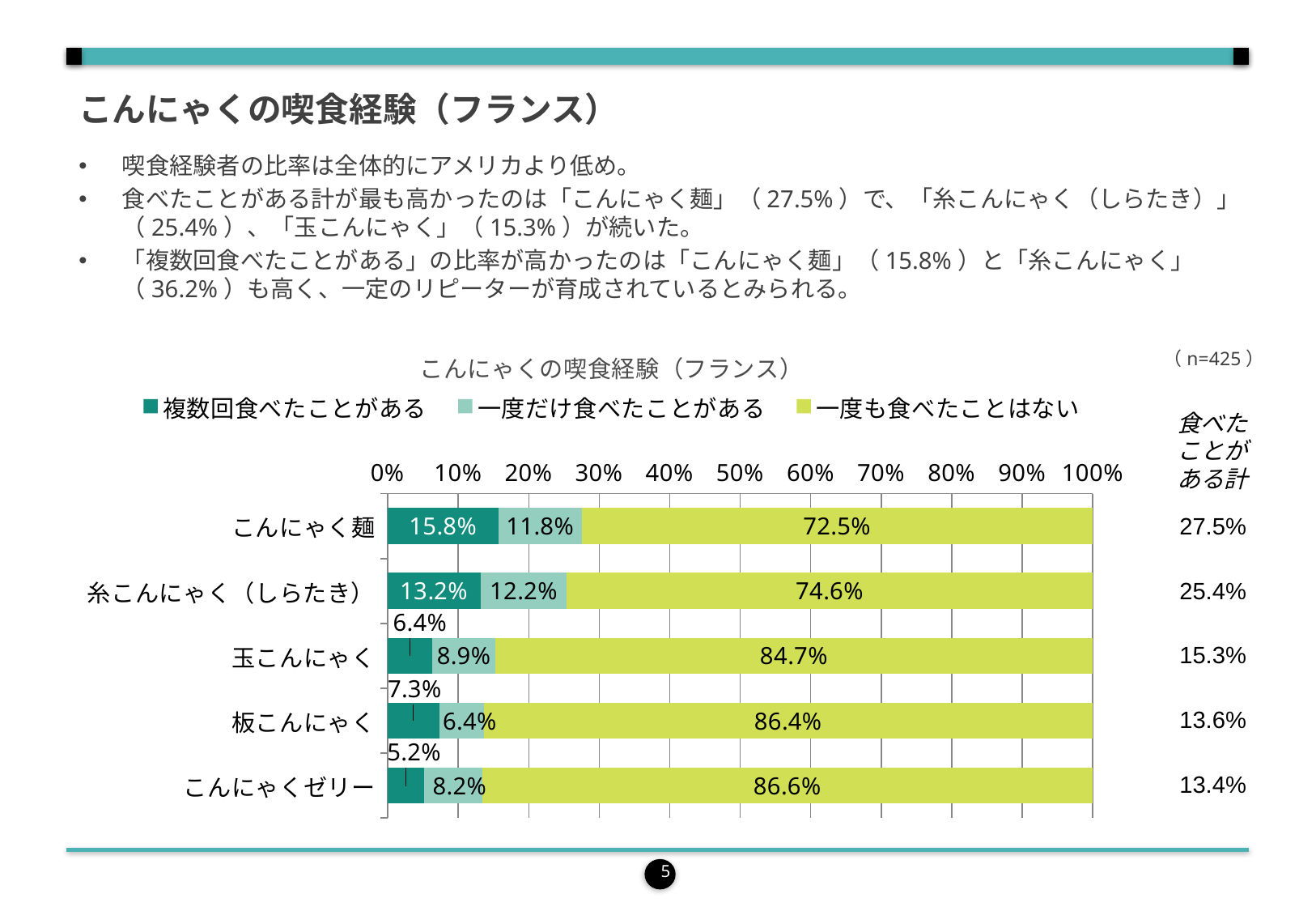
Is the 一度も食べたことはない value for こんにゃく麺 greater or less than 70%? greater What is the value of 一度も食べたことはない for 糸こんにゃく（しらたき）? 74.6% What is the combined total of 複数回食べたことがある and 一度だけ食べたことがある for 玉こんにゃく? 15.3% What is the difference between the 一度も食べたことはない values for 板こんにゃく and こんにゃく麺? 13.9% Which category has the highest value for 一度も食べたことはない? こんにゃくゼリー How many categories are shown on the chart? 5 Which category has the lowest value for 複数回食べたことがある? こんにゃくゼリー What is the value of 複数回食べたことがある for こんにゃく麺? 15.8% What is the value of 一度だけ食べたことがある for 玉こんにゃく? 8.9% What kind of chart is shown on the slide? Stacked bar chart How many series does the legend list? 3 Which is larger: the 複数回食べたことがある value for 糸こんにゃく（しらたき） or for 板こんにゃく? 糸こんにゃく（しらたき）